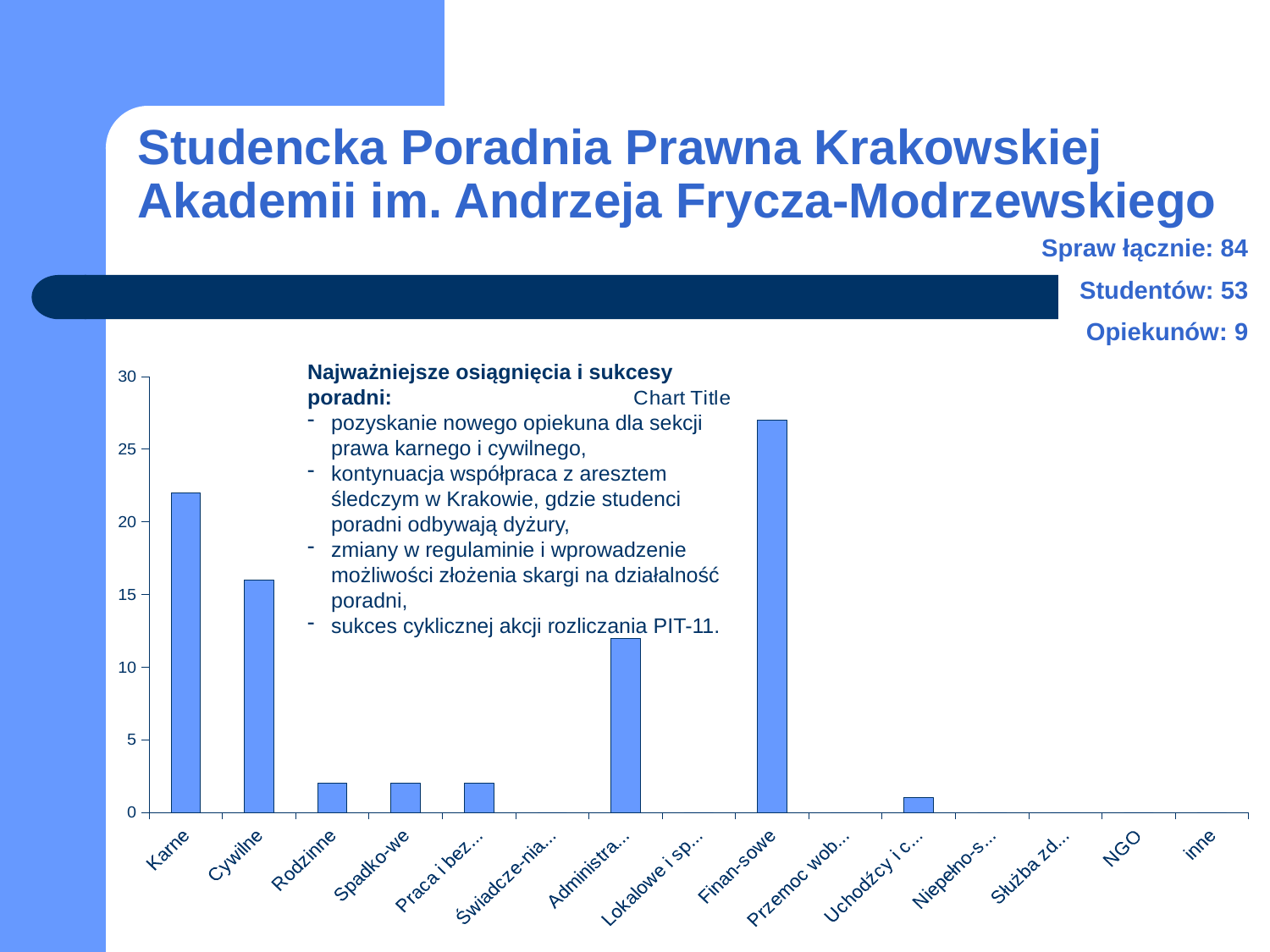
Is the value for Karne greater or less than 20? greater Is the value for Finan-sowe greater or less than 25? greater How many categories are shown on the x axis of the chart? 15 Is the value for Administra... greater or less than 10? greater Which category has the highest bar in the chart? Finan-sowe What is the title shown above the chart? Chart Title Which is larger, the value for Administra... or the value for Cywilne? Cywilne Which is larger, the value for Karne or the value for Cywilne? Karne What kind of chart is shown on the slide? bar chart